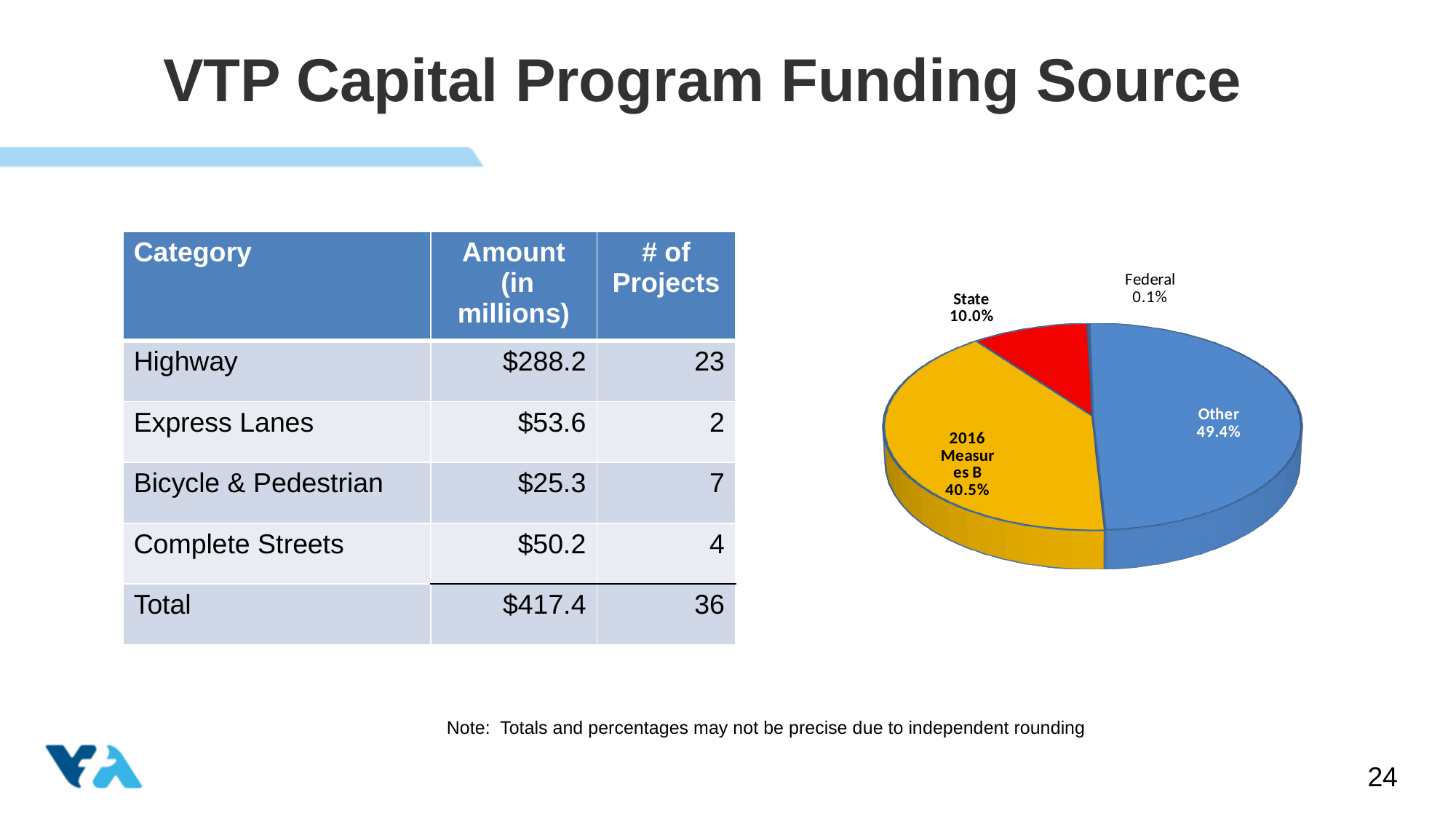
What share of the pie chart does Federal represent? 0.1% Which slice of the pie chart is the smallest? Federal Which slice of the pie chart is the largest? Other What kind of chart is shown on the slide? pie chart Which is larger in the pie chart, State or 2016 Measure B? 2016 Measure B What share of the pie chart does 2016 Measure B represent? 40.5% What share of the pie chart does State represent? 10.0% What is the difference in percentage points between the Other slice and the 2016 Measure B slice? 8.9 What colour is the State slice in the pie chart? red What colour is the 2016 Measure B slice in the pie chart? yellow How many slices does the pie chart have? 4